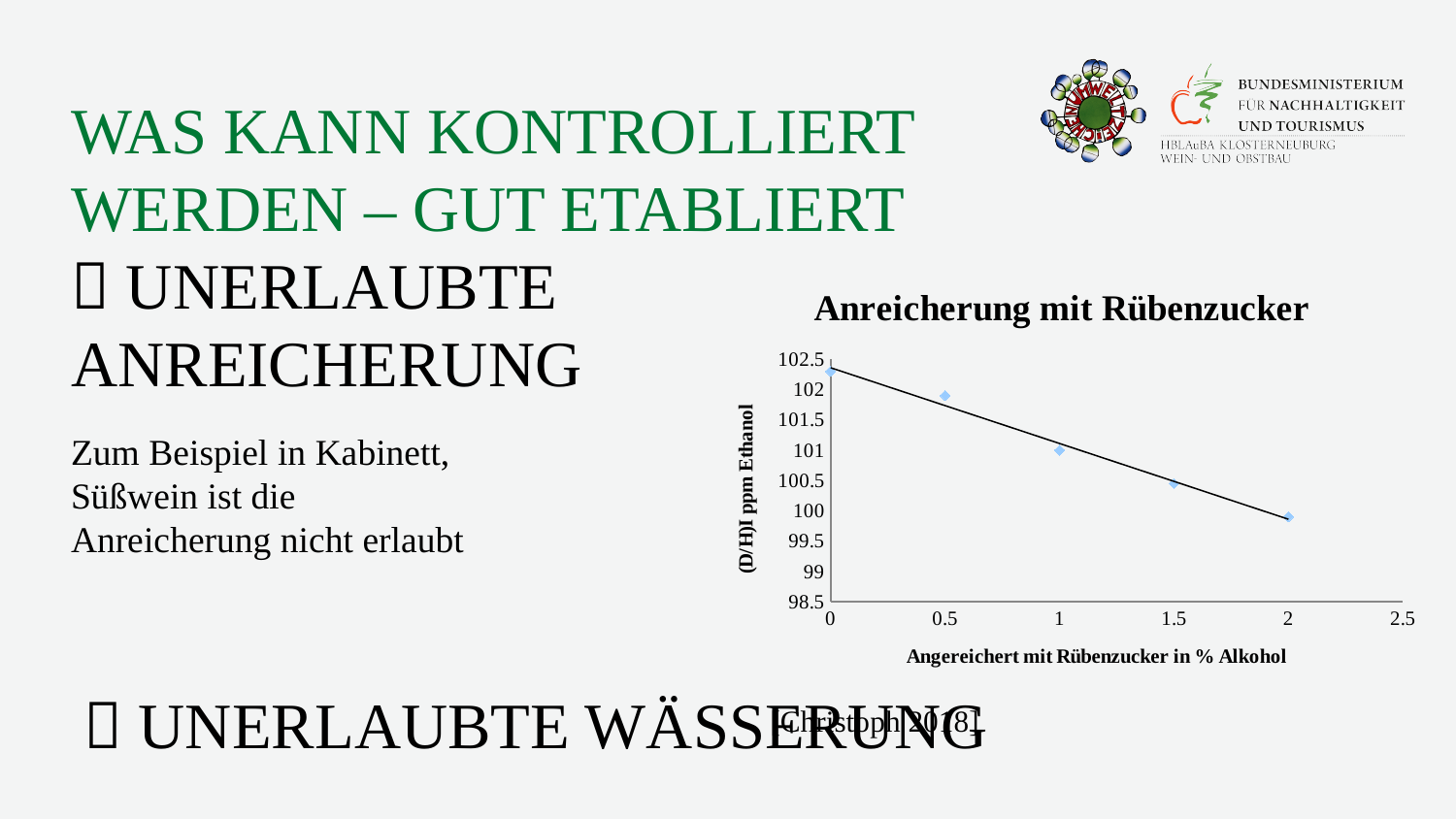
Is the (D/H)I ppm Ethanol value at 1.5 % Alkohol greater or less than 101? less Do the (D/H)I ppm Ethanol values rise or fall as the amount of Rübenzucker increases along the x axis? fall At which x value is the (D/H)I ppm Ethanol value lowest? 2 How many data points are plotted in the chart? 5 At which x value is the (D/H)I ppm Ethanol value highest? 0 Is the (D/H)I ppm Ethanol value at 2 % Alkohol greater or less than 100.5? less Is the (D/H)I ppm Ethanol value at 0.5 % Alkohol greater or less than 101.5? greater What is the title of the chart? Anreicherung mit Rübenzucker Which has the larger (D/H)I ppm Ethanol value: the point at 0.5 % Alkohol or the point at 1.5 % Alkohol? 0.5 % Alkohol What is the label of the x axis of the chart? Angereichert mit Rübenzucker in % Alkohol What kind of chart is shown on the slide? scatter chart